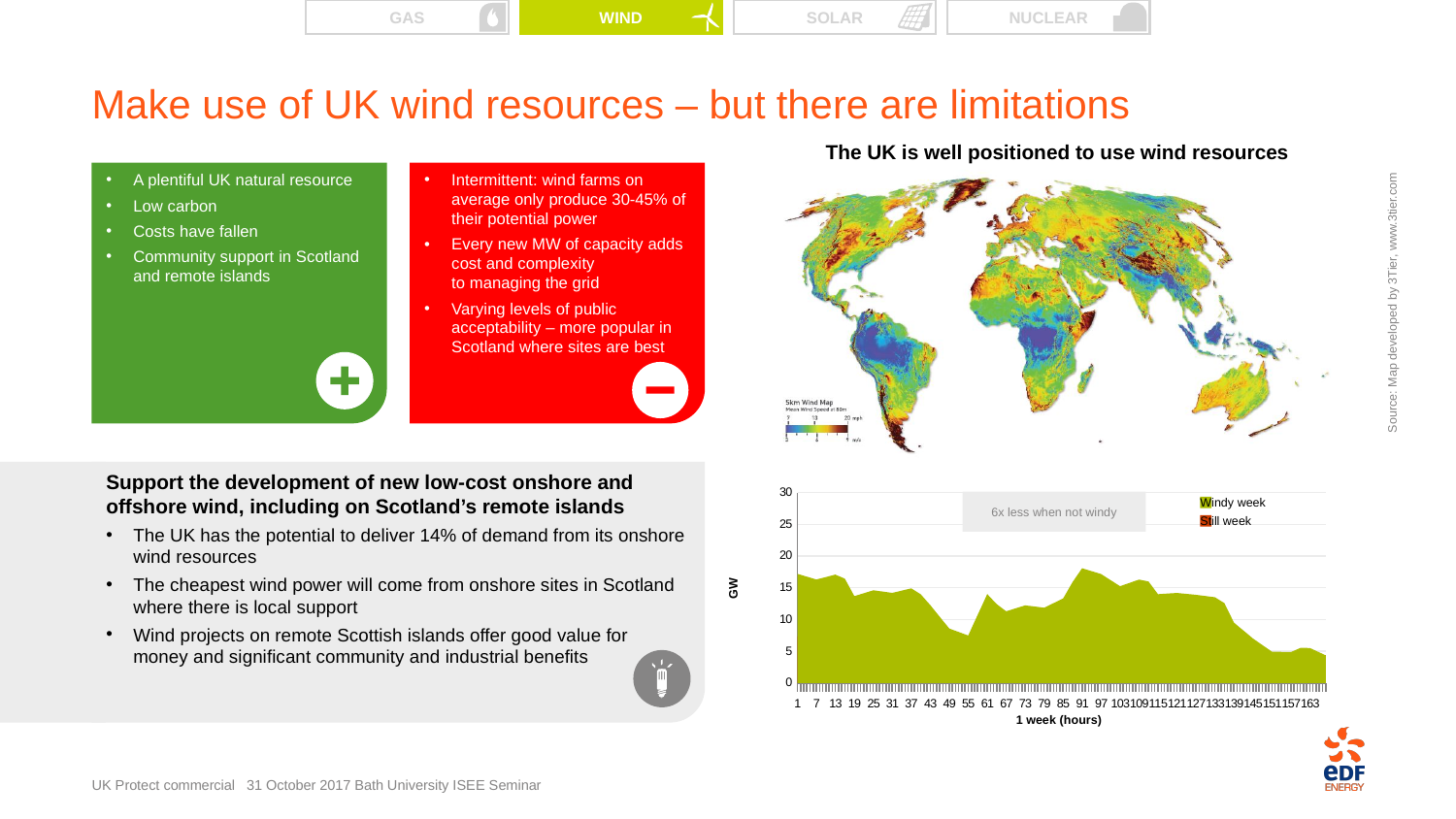
On the bottom-right chart, is the value at hour 1 greater or less than 15? greater What is the highest tick value shown on the y axis of the bottom-right chart? 30 On the bottom-right chart, is the value at hour 91 greater or less than 15? greater On the bottom-right chart, do the values overall rise or fall from the start of the week to the end? fall What is the label of the y axis on the bottom-right chart? GW What kind of chart is shown at the bottom right of the slide? Area chart How many series does the legend of the bottom-right chart list? 2 What is the label of the x axis on the bottom-right chart? 1 week (hours) What are the two legend entries of the bottom-right chart? Windy week and Still week What is the last hour label shown on the x axis of the bottom-right chart? 163 What does the annotation text inside the bottom-right chart say? 6x less when not windy